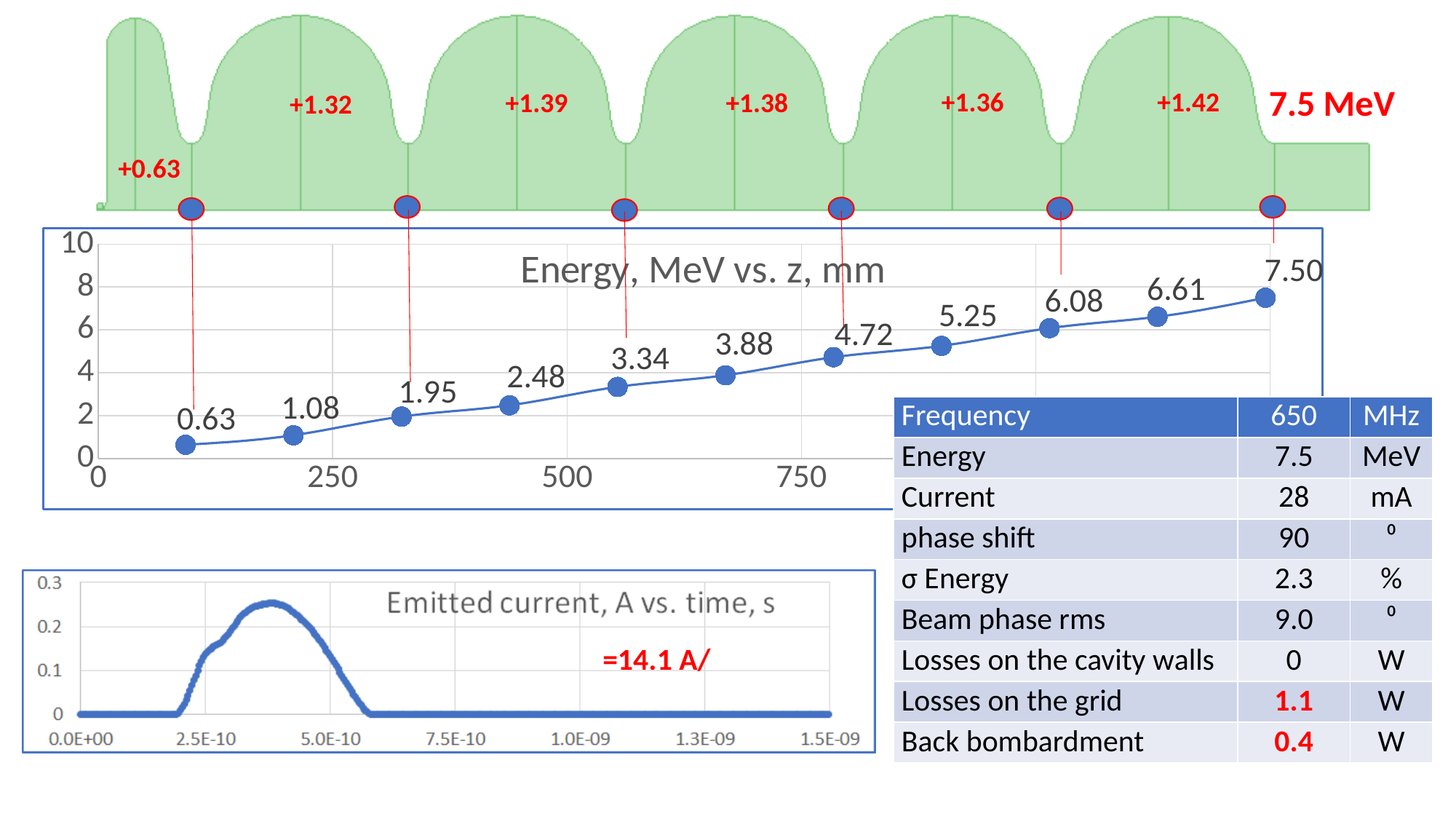
In the 'Energy, MeV vs. z, mm' chart, what is the lowest plotted value? 0.63 In the 'Emitted current, A vs. time, s' chart, what kind of chart is shown? line chart In the 'Energy, MeV vs. z, mm' chart, what is the value of the last data point? 7.50 In the 'Energy, MeV vs. z, mm' chart, do the values rise or fall as z increases? rise In the 'Energy, MeV vs. z, mm' chart, what kind of chart is shown? line chart In the 'Energy, MeV vs. z, mm' chart, what is the difference between the last value (7.50) and the first value (0.63)? 6.87 In the 'Energy, MeV vs. z, mm' chart, what is the highest plotted value? 7.50 What is the title of the chart in the middle of the slide? Energy, MeV vs. z, mm In the 'Emitted current, A vs. time, s' chart, is the peak value greater or less than 0.2? greater In the 'Energy, MeV vs. z, mm' chart, how many data points are plotted? 11 In the 'Energy, MeV vs. z, mm' chart, which is larger: the point labelled 3.34 or the point labelled 2.48? 3.34 In the 'Energy, MeV vs. z, mm' chart, what is the value of the first data point? 0.63